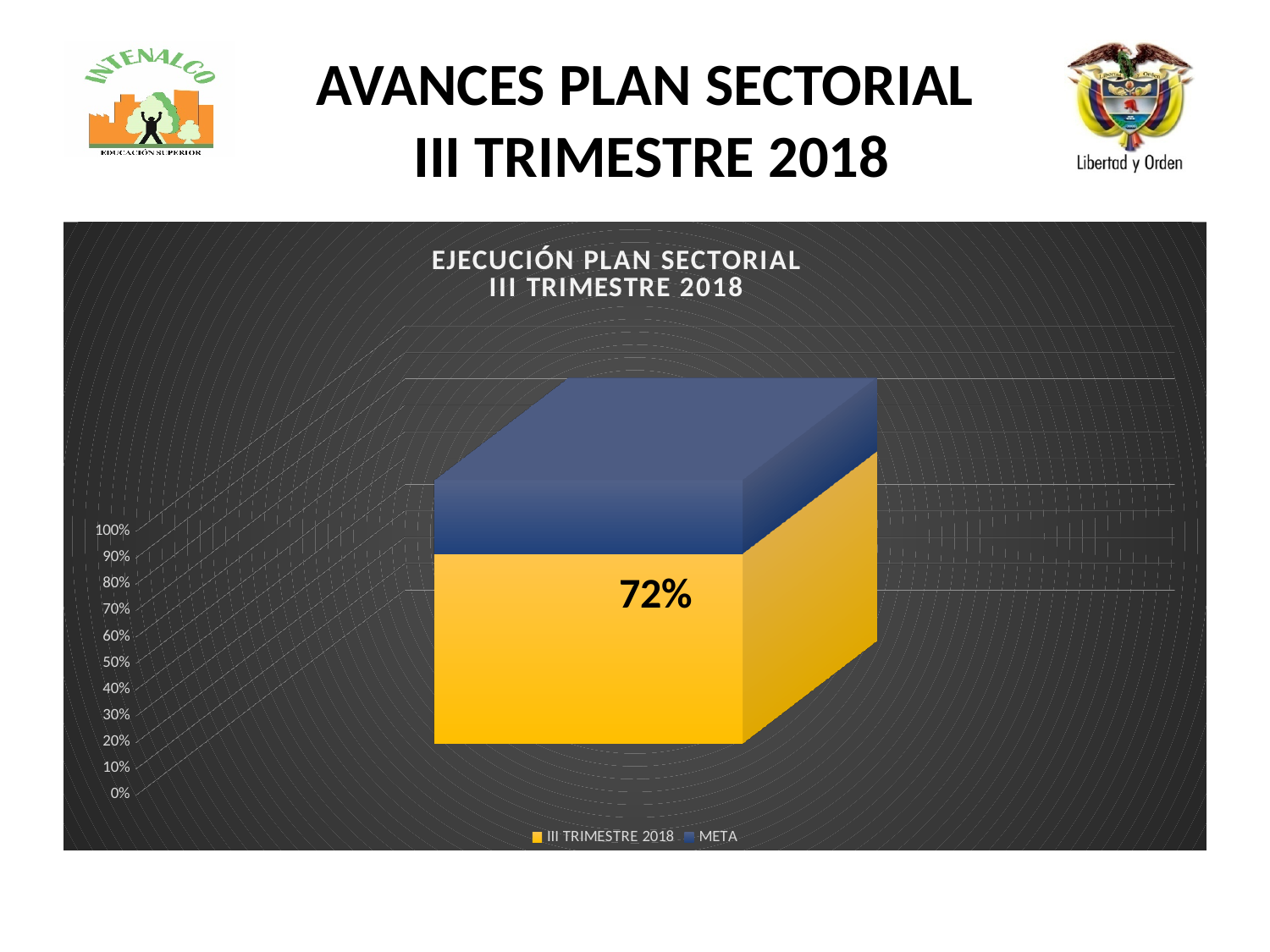
Is the value for III TRIMESTRE 2018 greater or less than 80%? less What kind of chart is shown on the slide? bar chart What is the title of the chart? EJECUCIÓN PLAN SECTORIAL III TRIMESTRE 2018 How many bars are plotted in the chart? 1 What is the highest value shown on the vertical axis of the chart? 100% Is the value for III TRIMESTRE 2018 greater or less than 50%? greater How many series does the chart legend list? 2 Which series is shown in yellow in the chart? III TRIMESTRE 2018 What is the value shown for III TRIMESTRE 2018 in the chart? 72%